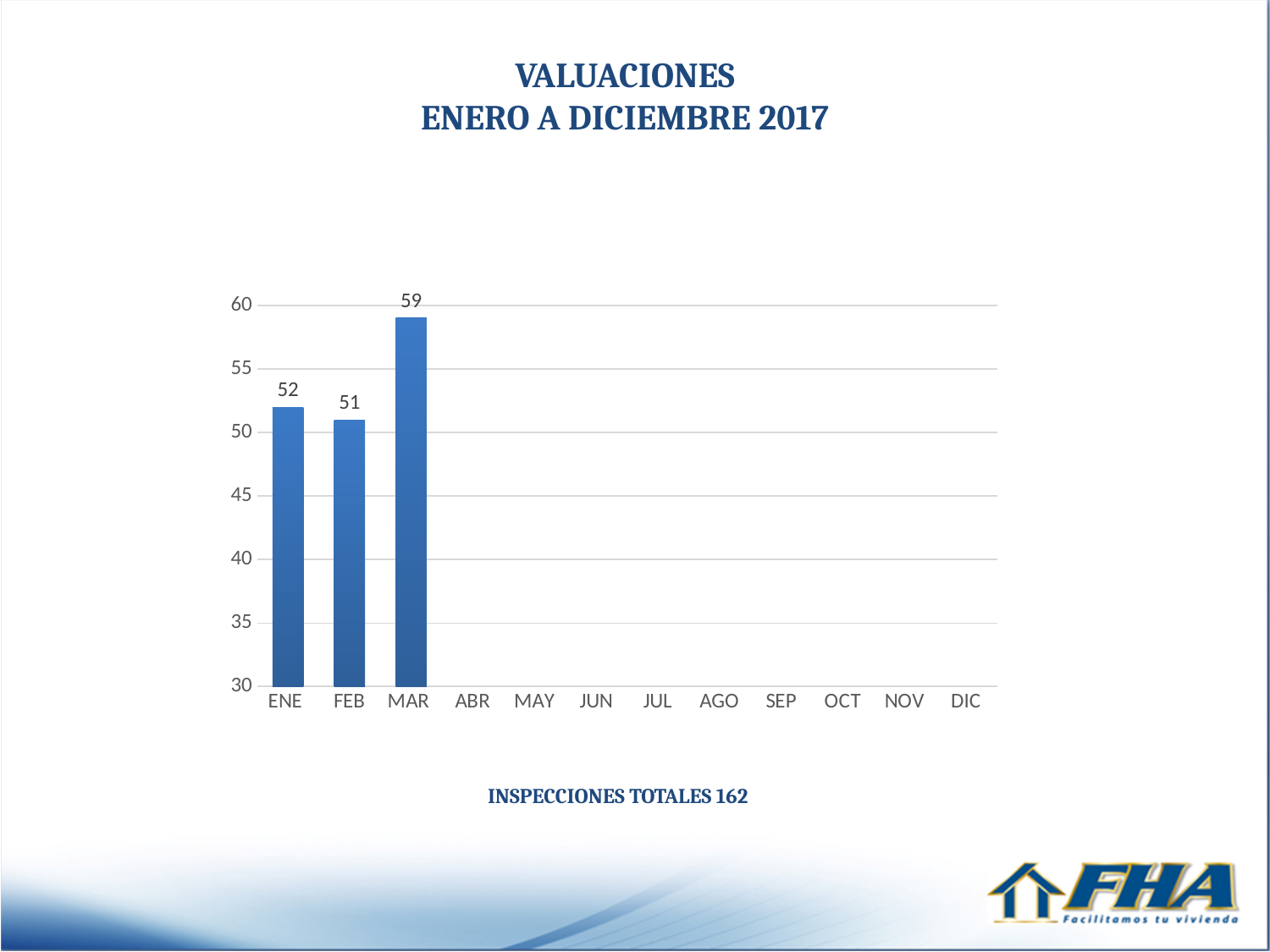
How many months have a plotted bar? 3 What is the value for MAR? 59 What is the difference between the values for MAR and FEB? 8 What is the value for FEB? 51 Which month has the highest value? MAR What is the value for ENE? 52 Which month with a plotted bar has the lowest value? FEB How many month categories are shown on the x axis? 12 Is the value for MAR greater or less than 55? greater What kind of chart is shown on the slide? bar chart Which is larger, the value for ENE or the value for MAR? MAR What is the title of the slide? VALUACIONES ENERO A DICIEMBRE 2017